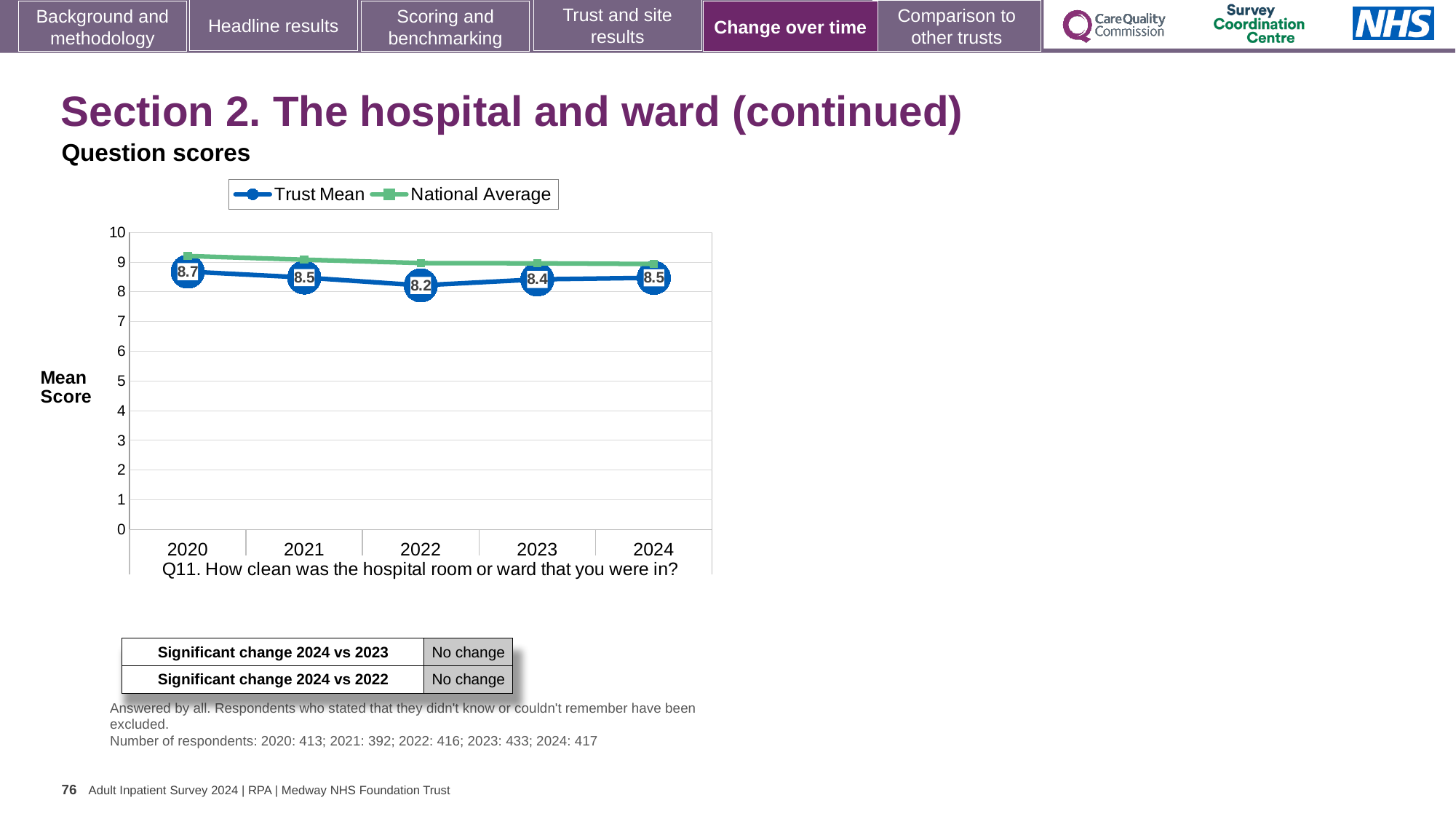
What kind of chart is shown on the slide? Line chart What is the difference between the Trust Mean in 2020 and in 2022? 0.5 In which year is the Trust Mean lowest? 2022 What is the Trust Mean value for 2022? 8.2 In which year is the Trust Mean highest? 2020 What is the Trust Mean value for 2024? 8.5 What is the Trust Mean value for 2020? 8.7 Does the Trust Mean rise or fall from 2020 to 2022? Fall Is the National Average value for 2020 greater or less than 9? greater Which is larger, the Trust Mean in 2021 or in 2023? 2021 How many series does the legend list? 2 How many years are shown on the x axis? 5